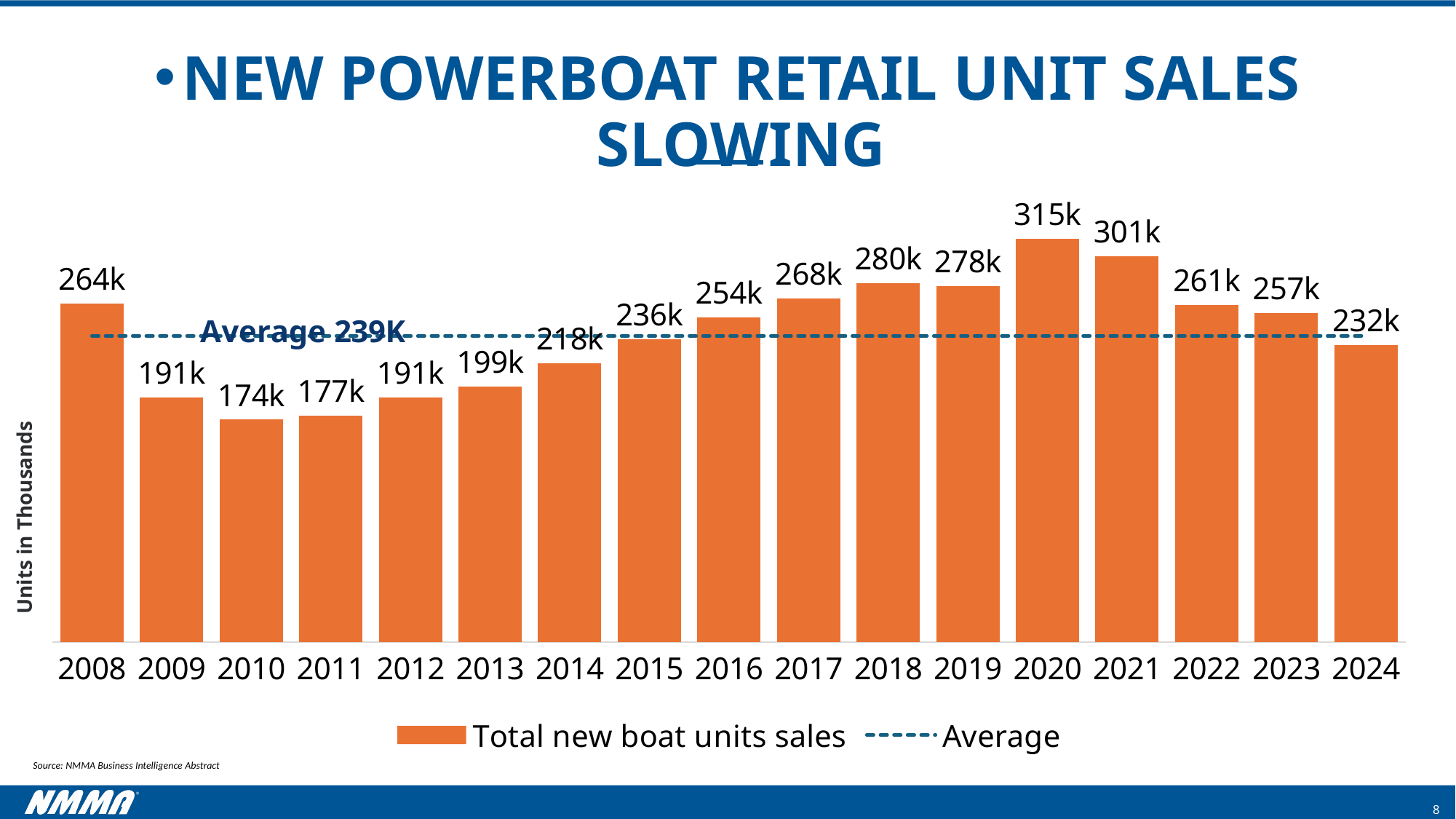
Which year had higher total new boat unit sales, 2008 or 2016? 2008 How many series does the legend list? 2 What kind of chart is shown on the slide? Bar chart Which year had the highest total new boat unit sales? 2020 Did total new boat unit sales rise or fall from 2020 to 2024? Fall What was the value of total new boat unit sales in 2020? 315k What average value is labelled on the dashed line in the chart? Average 239K What is the difference between total new boat unit sales in 2020 and 2024? 83k Which year had the lowest total new boat unit sales? 2010 What was the value of total new boat unit sales in 2010? 174k How many years are shown on the x axis of the chart? 17 What was the value of total new boat unit sales in 2024? 232k